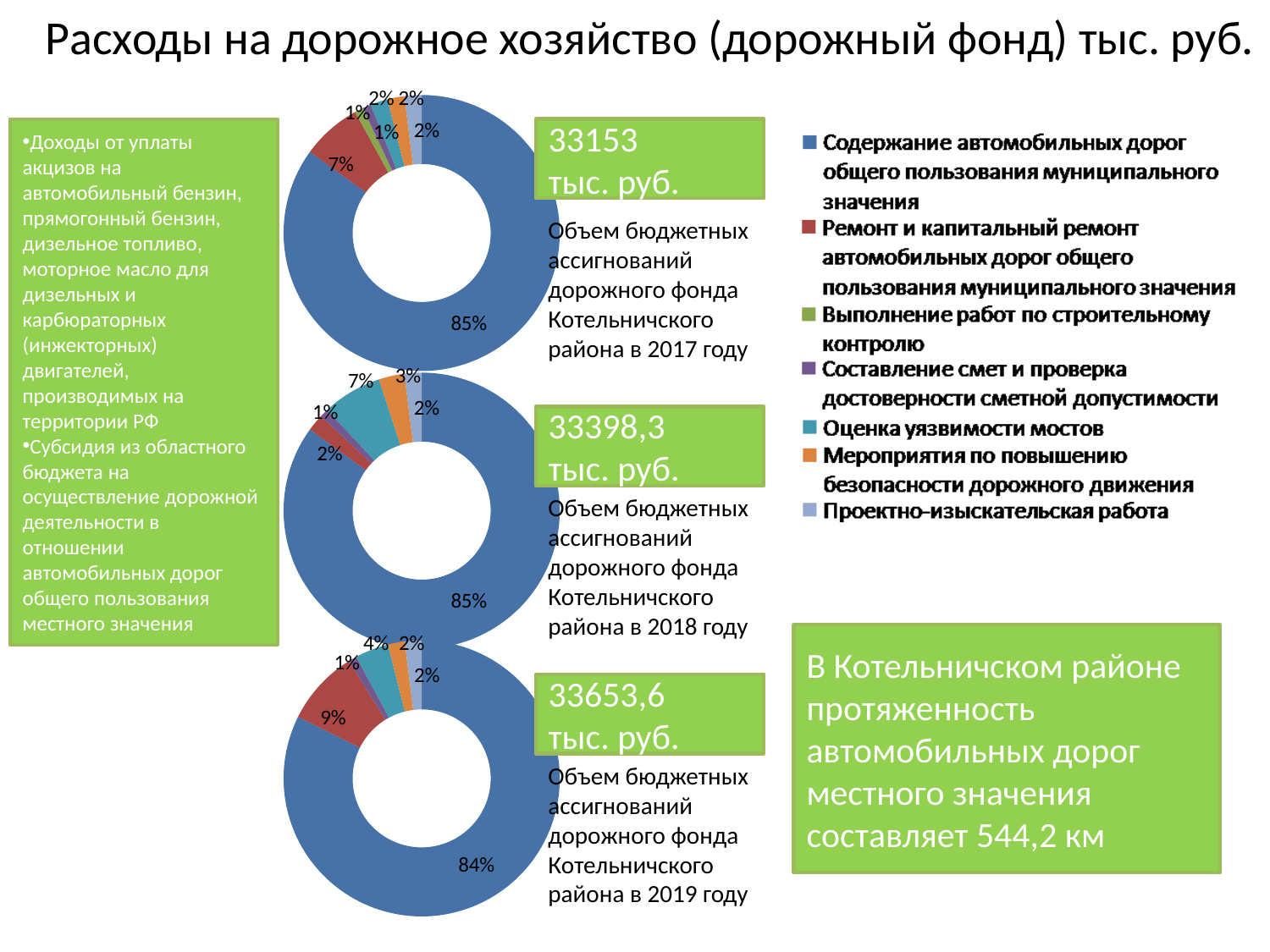
In the 2019 chart, what share is shown for 'Ремонт и капитальный ремонт автомобильных дорог общего пользования муниципального значения'? 9% In the 2017 chart, what is the difference between the share for road maintenance (85%) and the share for road repair (7%)? 78 percentage points What total budget allocation is shown next to the 2018 chart? 33398,3 тыс. руб. Which is larger in the 2019 chart: the share for 'Ремонт и капитальный ремонт' or the share for 'Оценка уязвимости мостов'? Ремонт и капитальный ремонт In the 2018 chart, what share is shown for 'Оценка уязвимости мостов'? 7% What kind of chart is used to show the 2017 road fund budget allocations? doughnut (pie) chart In the 2017 chart, what share is shown for 'Ремонт и капитальный ремонт автомобильных дорог общего пользования муниципального значения'? 7% How many categories does the legend list for the road fund charts? 7 In the 2019 chart, which category has the largest share? Содержание автомобильных дорог общего пользования муниципального значения